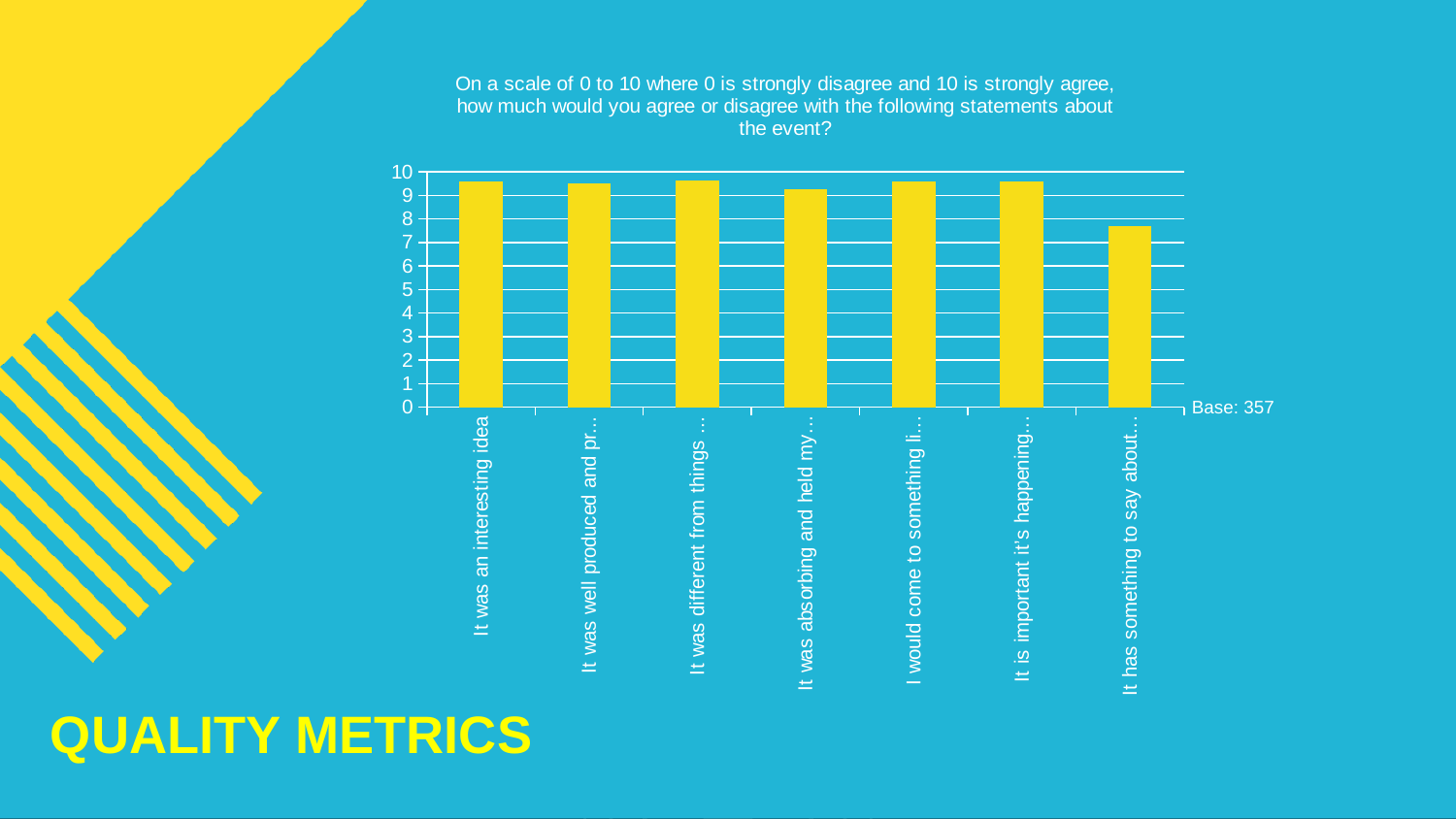
Which is larger: the value for "It was an interesting idea" or the value for "It has something to say about…"? It was an interesting idea Is the value for "It was an interesting idea" greater or less than 9? greater What base (number of respondents) is noted next to the chart? Base: 357 Is the value for "It was absorbing and held my…" greater or less than 9? greater Which statement has the lowest bar in the chart? It has something to say about… Which is larger: the value for "It is important it's happening…" or the value for "It has something to say about…"? It is important it's happening… How many bars (statements) are plotted in the chart? 7 Is the value for "It has something to say about…" greater or less than 8? less What kind of chart is shown on the slide? bar chart What is the maximum value shown on the chart's vertical axis? 10